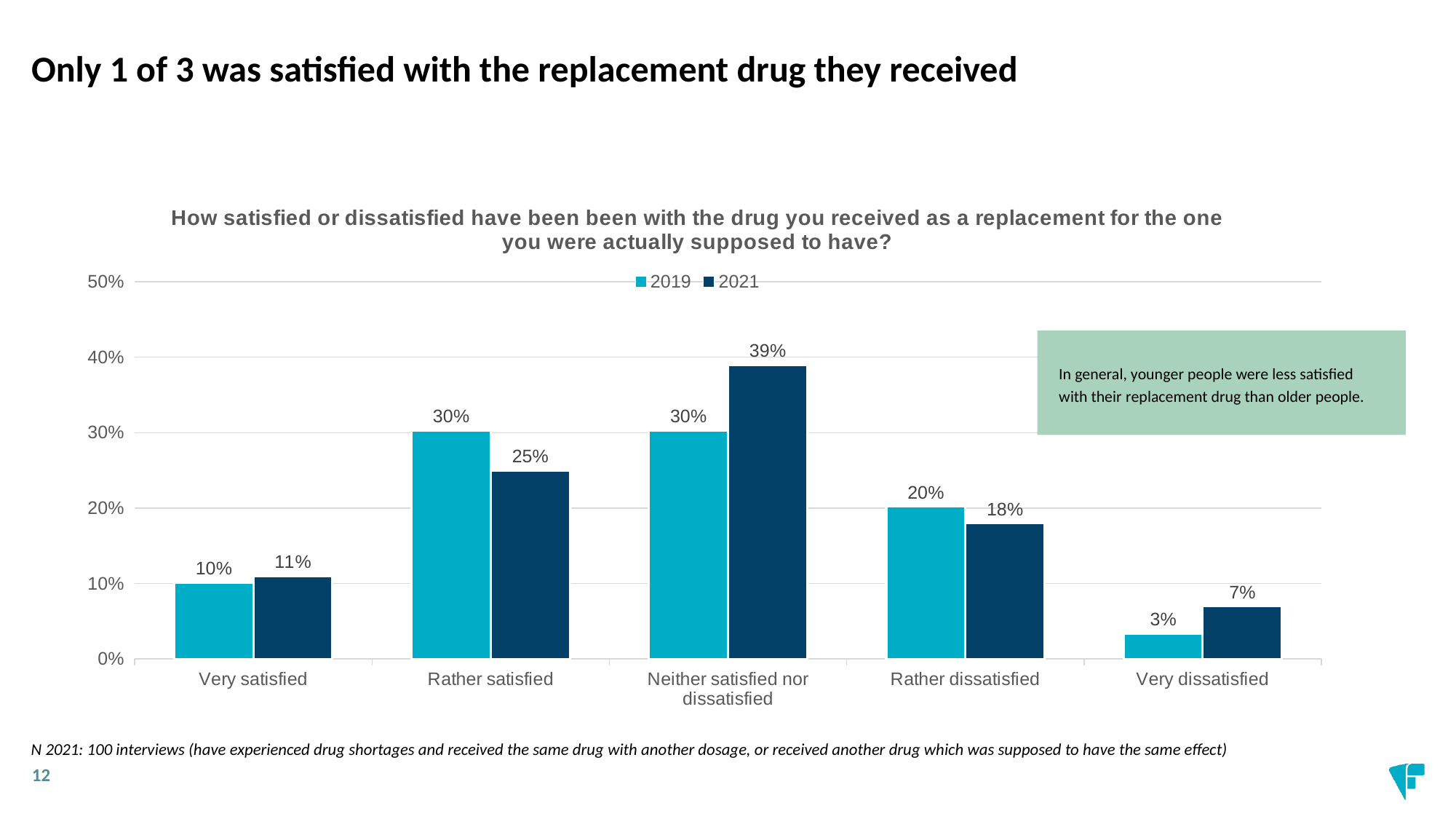
What is the difference between the 2019 and 2021 values for Rather satisfied? 5% What is the difference between the 2021 and 2019 values for Neither satisfied nor dissatisfied? 9% Which is larger for Rather dissatisfied, the 2019 value or the 2021 value? 2019 What is the 2021 value for Neither satisfied nor dissatisfied? 39% How many series does the legend list? 2 What is the 2019 value for Rather satisfied? 30% Which category has the lowest 2019 value? Very dissatisfied How many categories are shown on the x axis? 5 What is the 2021 value for Very dissatisfied? 7% Which category has the highest 2021 value? Neither satisfied nor dissatisfied What kind of chart is shown on the slide? Bar chart Is the 2021 value for Neither satisfied nor dissatisfied greater or less than 30%? greater